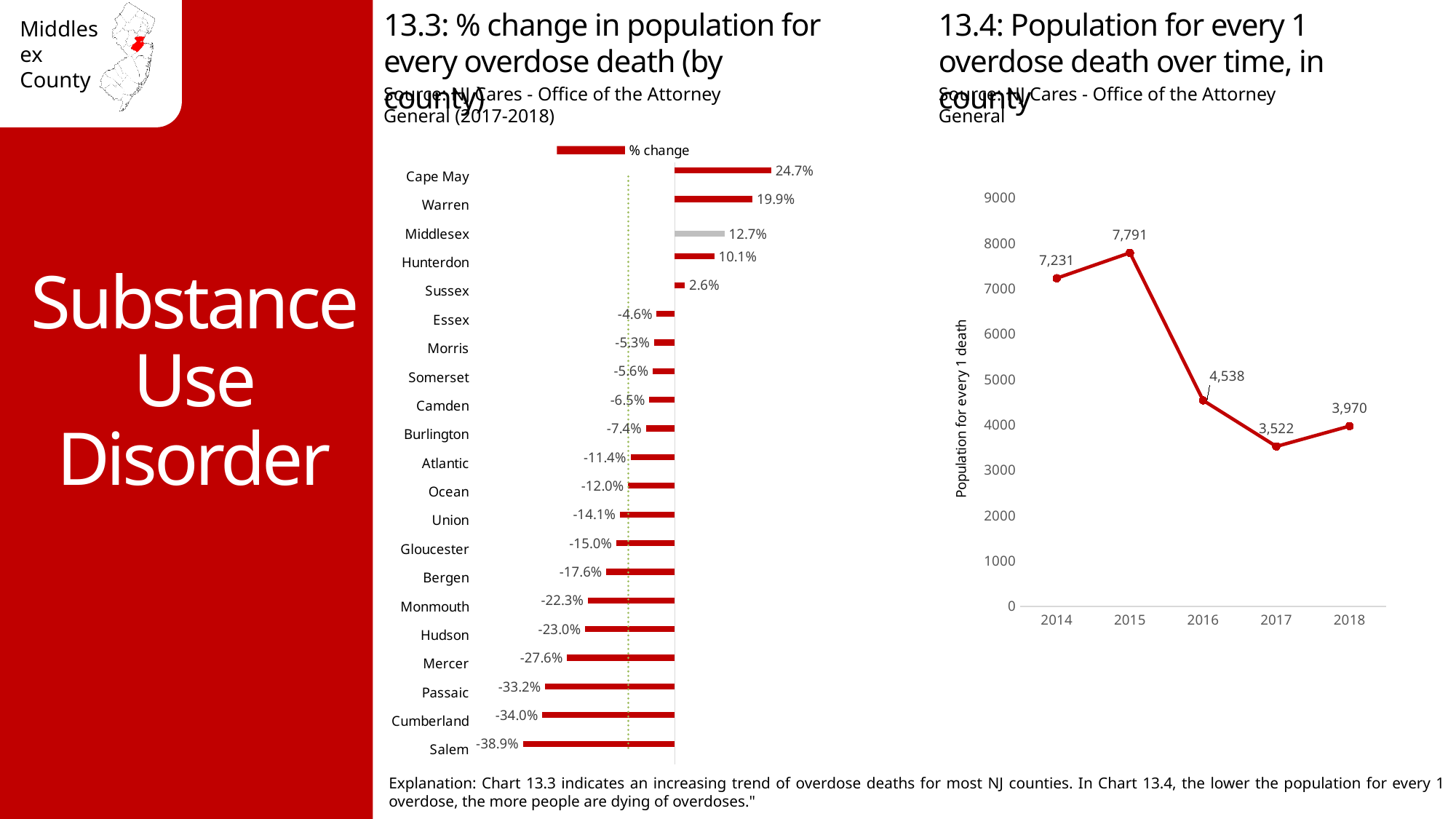
In chart 13.4, which year has the lowest population for every 1 overdose death? 2017 In chart 13.4, how many years are plotted? 5 In chart 13.3, which has a larger % change, Warren or Hunterdon? Warren In chart 13.3, what is the % change for Salem? -38.9% In chart 13.4, what is the difference between the 2014 and 2018 values? 3,261 In chart 13.3, which county has the highest % change? Cape May In chart 13.3, what is the difference between the % change for Cape May and Warren? 4.8% What type of chart is chart 13.4? Line chart In chart 13.3, what is the % change for Middlesex? 12.7% In chart 13.3, how many counties are shown? 21 In chart 13.3, which county has the lowest % change? Salem In chart 13.4, what is the population for every 1 overdose death in 2015? 7,791